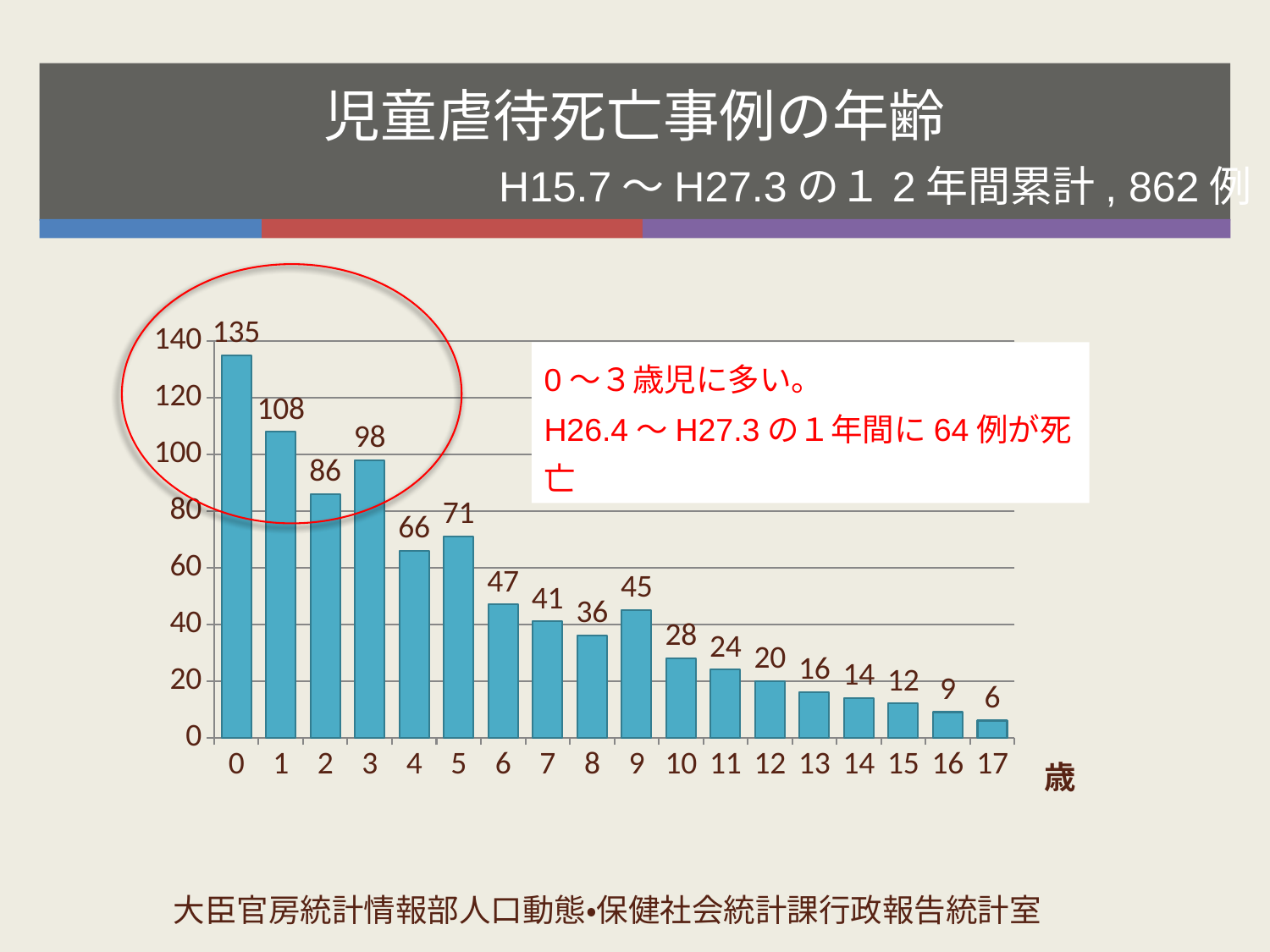
What kind of chart is shown on the slide? bar chart Which age has the lowest value? 17 What is the difference between the values for age 0 and age 1? 27 Which is larger, the value for age 2 or the value for age 3? age 3 Is the value for age 5 greater or less than 60? greater What is the value for age 3? 98 What is the value for age 9? 45 Do the values generally rise or fall as age increases from 9 to 17? fall What is the title of the slide's chart? 児童虐待死亡事例の年齢 How many age categories are shown on the x axis? 18 Which age has the highest value? 0 What is the value for age 0? 135